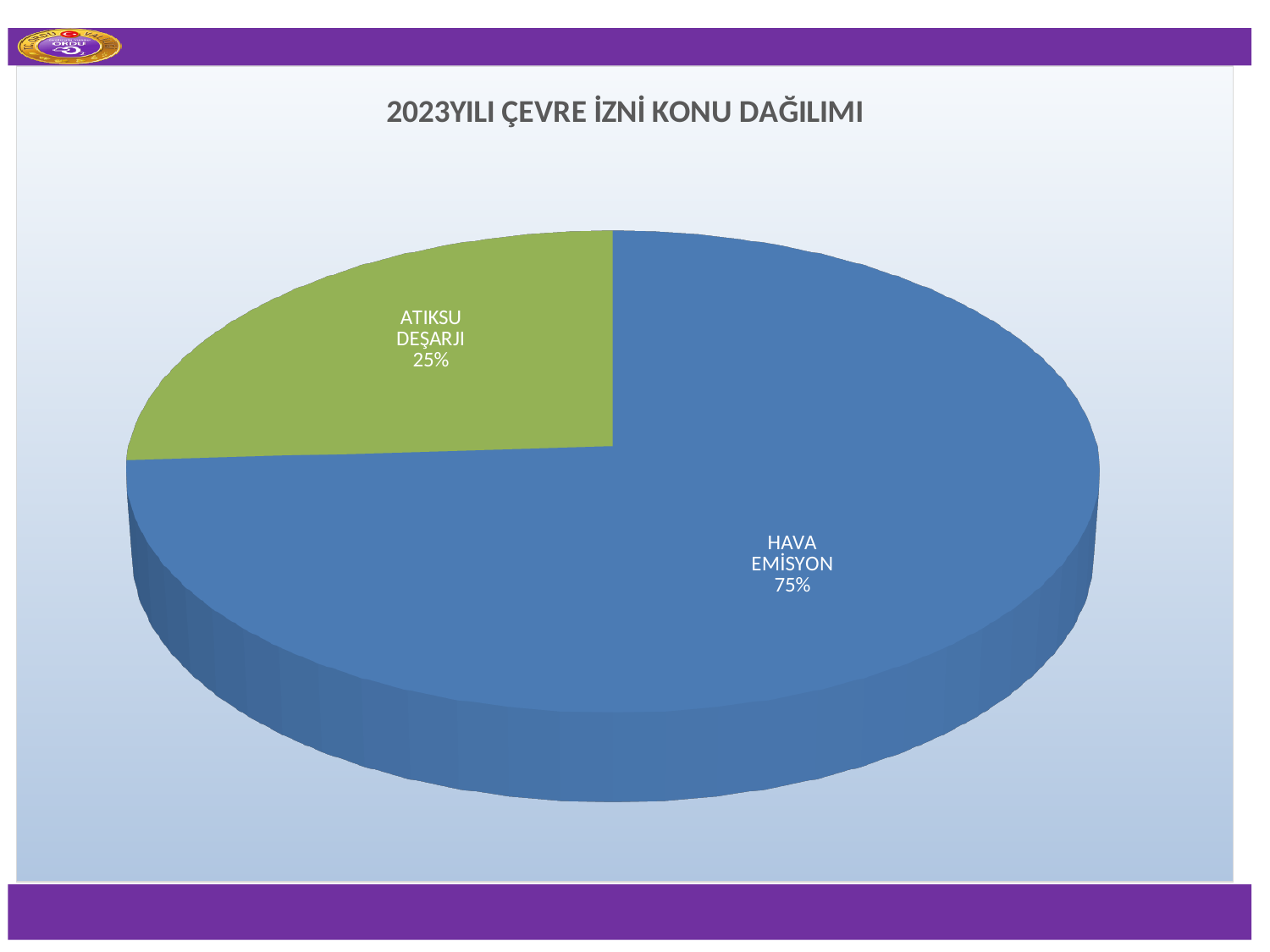
What share of the pie does HAVA EMİSYON take? 75% Which is larger, the share for ATIKSU DEŞARJI or the share for HAVA EMİSYON? HAVA EMİSYON How many slices does the pie chart have? 2 What is the title of the chart? 2023YILI ÇEVRE İZNİ KONU DAĞILIMI Which category has the largest slice of the pie? HAVA EMİSYON What is the difference in percentage points between HAVA EMİSYON and ATIKSU DEŞARJI? 50 Which category has the smallest slice of the pie? ATIKSU DEŞARJI What colour is the HAVA EMİSYON slice? blue What share of the pie does ATIKSU DEŞARJI take? 25% What kind of chart is shown on the slide? pie chart